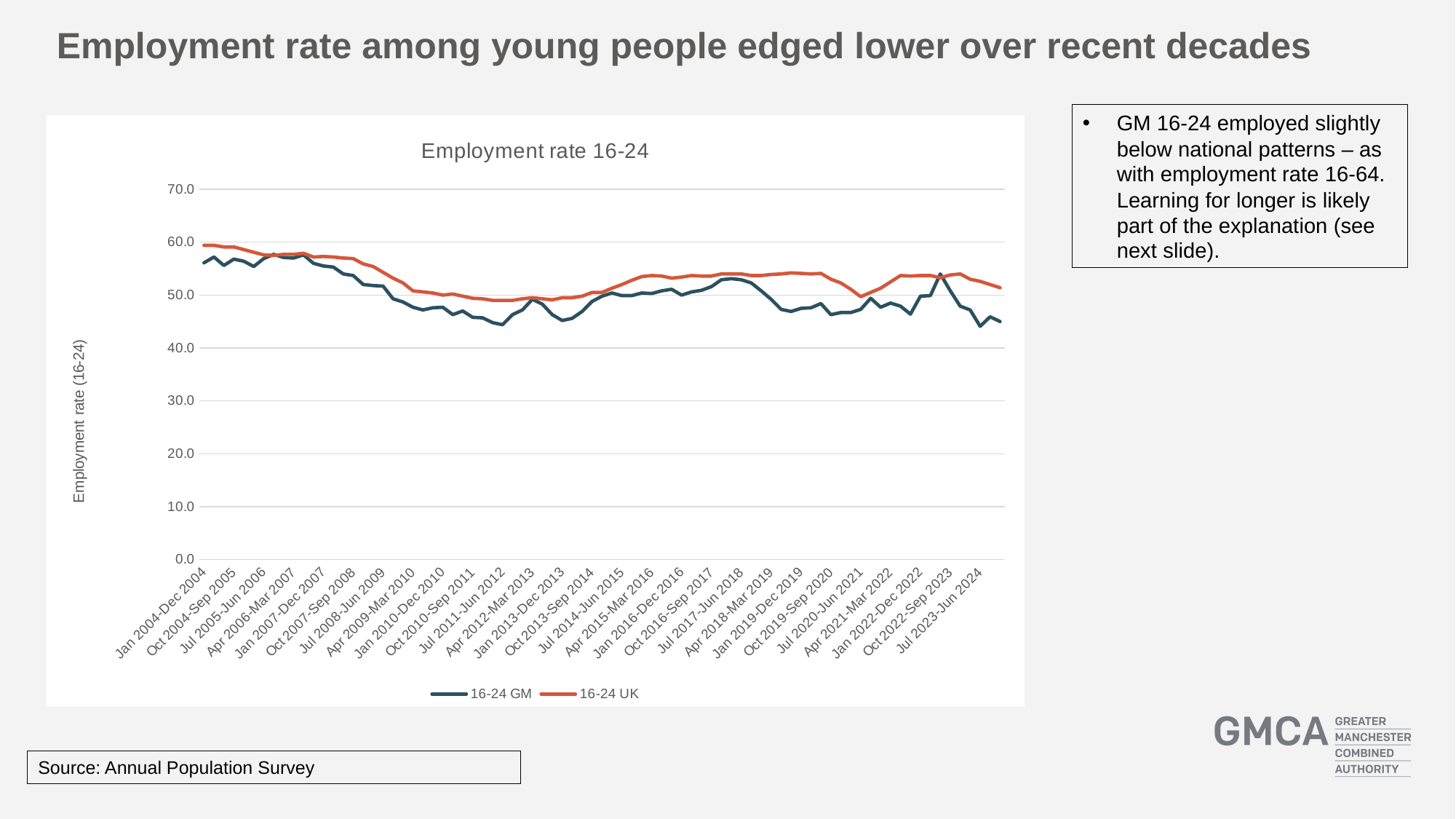
Does the 16-24 UK series rise or fall between Jan 2004-Dec 2004 and Jul 2023-Jun 2024? Fall What kind of chart is shown on the slide? Line chart Which series is drawn in orange in the chart? 16-24 UK Is the value for 16-24 UK at Apr 2018-Mar 2019 greater or less than 50? greater Is the value for 16-24 GM at Jul 2023-Jun 2024 greater or less than 50? less Is the value for 16-24 GM at Jan 2004-Dec 2004 greater or less than 50? greater At Jul 2011-Jun 2012, which series has the higher value, 16-24 GM or 16-24 UK? 16-24 UK What is the title of the chart? Employment rate 16-24 At Jul 2023-Jun 2024, which series has the higher value, 16-24 GM or 16-24 UK? 16-24 UK Does the 16-24 GM series rise or fall between Jan 2004-Dec 2004 and Jul 2011-Jun 2012? Fall How many series does the chart's legend list? 2